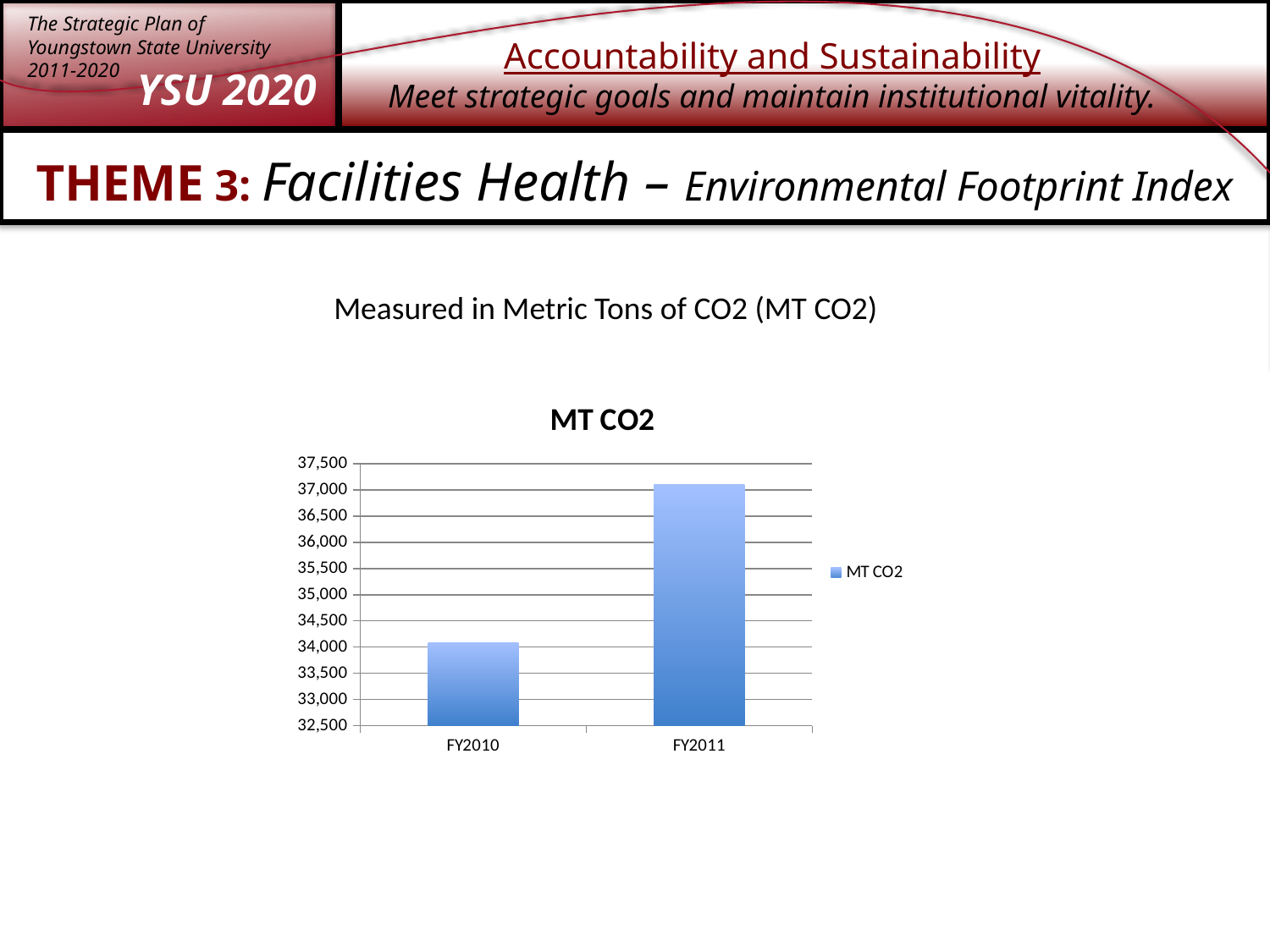
Which is larger, the value for FY2010 or the value for FY2011? FY2011 Which fiscal year has the lowest MT CO2 value? FY2010 Is the value for FY2010 greater or less than 33,500? greater What is the title of the chart? MT CO2 How many categories are shown on the x axis of the chart? 2 Do the values rise or fall from FY2010 to FY2011? rise Which fiscal year has the highest MT CO2 value? FY2011 What series name is shown in the legend? MT CO2 Is the value for FY2010 greater or less than 34,500? less How many series does the legend list? 1 What type of chart is shown on the slide? bar chart